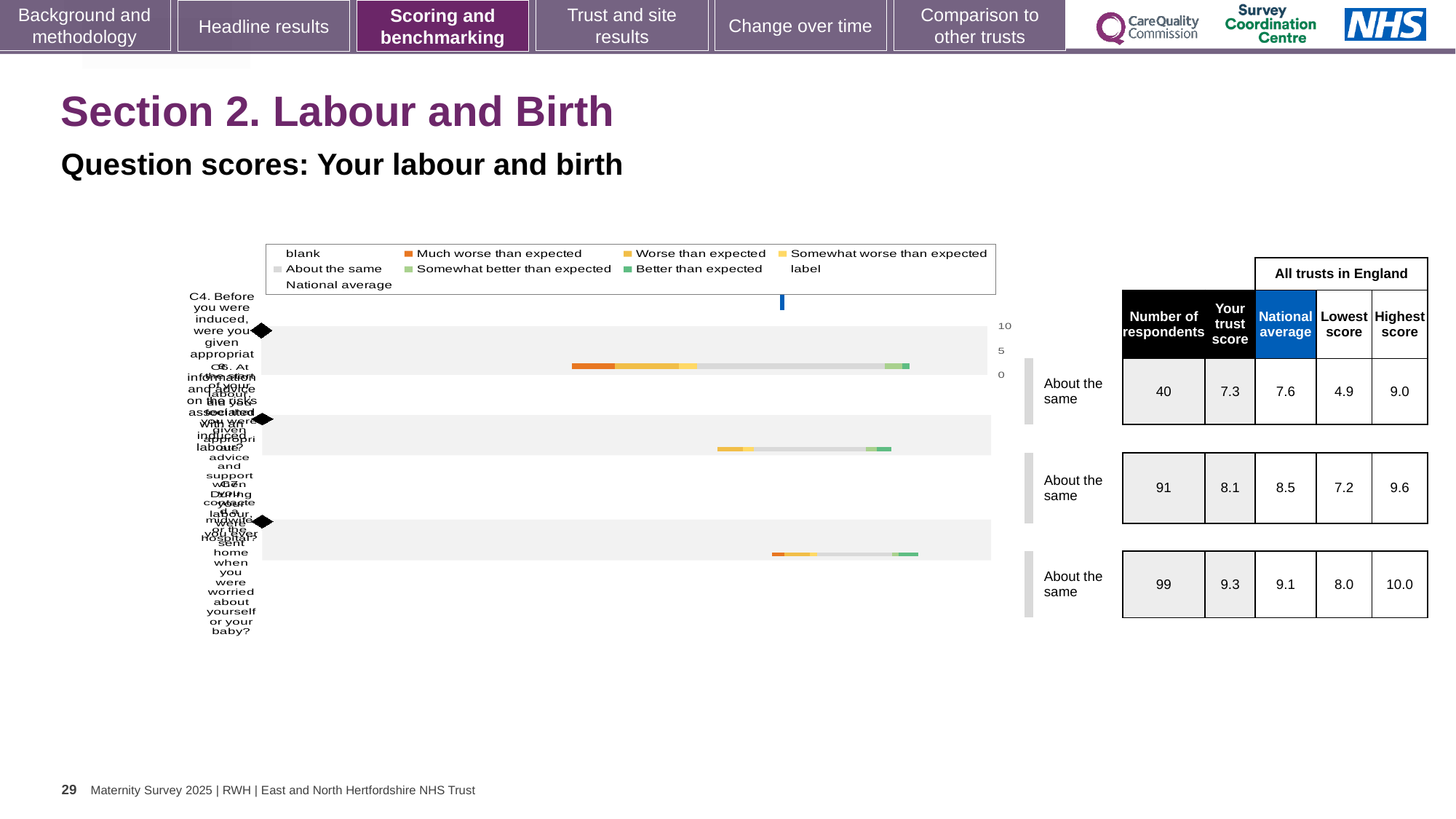
In the table beside the chart, which row has the largest number of respondents? the third row (99) In the table beside the chart, what is the lowest score for the second row? 7.2 How many entries does the chart legend list? 9 How many horizontal bars are plotted in the chart? 3 What kind of chart is shown on the slide? bar chart In the table beside the chart, is the trust score or the national average larger in the third row? the trust score (9.3) In the table beside the chart, what is the difference between the highest score and the lowest score in the first row? 4.1 What benchmark label is shown next to each of the three bars? About the same In the table beside the chart, what is the national average for the second row? 8.5 In the table beside the chart, what is the highest score for the third row? 10.0 In the table beside the chart, what is the number of respondents for the first row? 40 In the table beside the chart, what is the trust score for the first row? 7.3